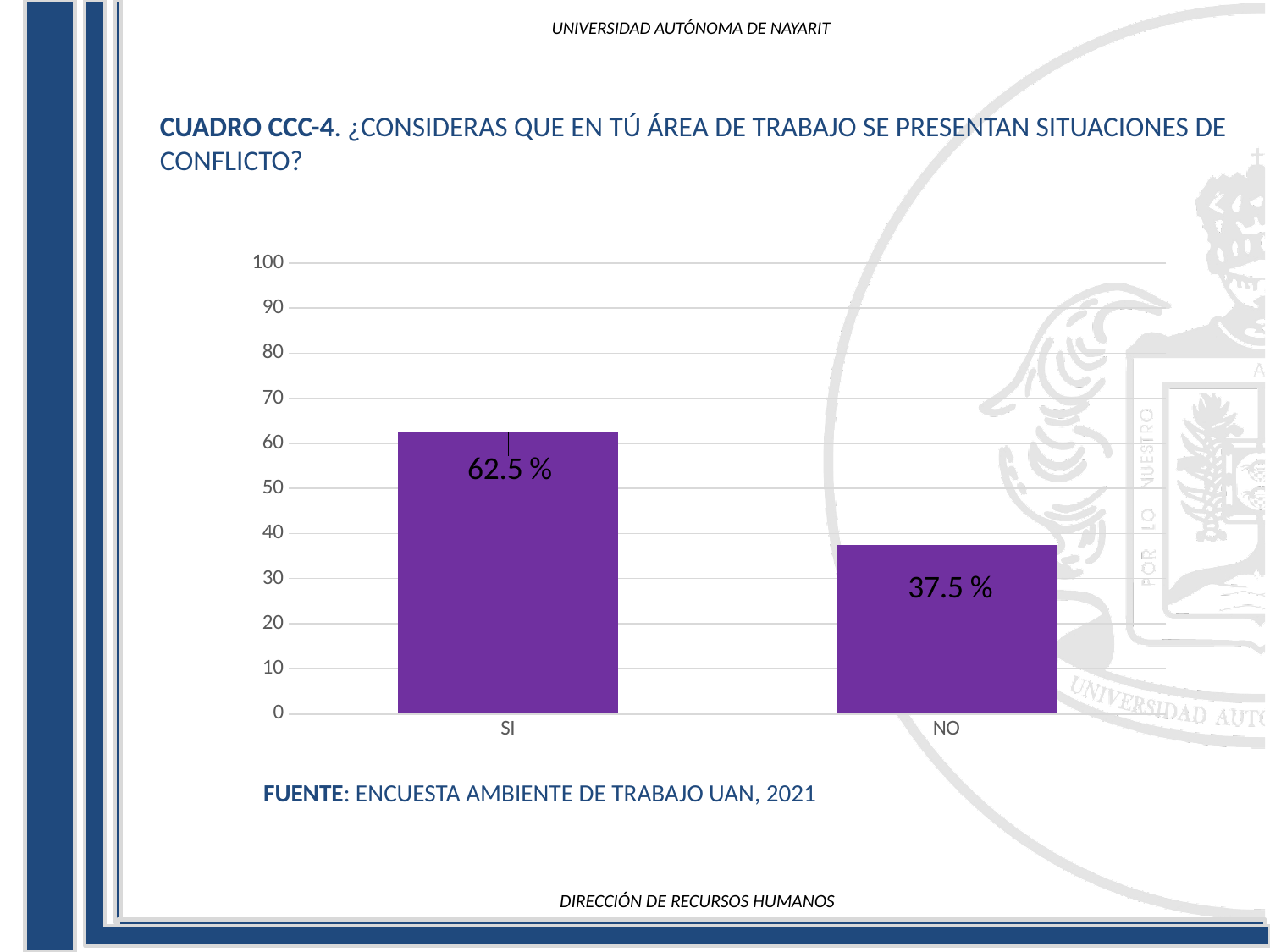
What is the highest value shown on the y axis? 100 Which is larger, the value for SI or the value for NO? SI What is the difference between the values for SI and NO? 25 % Is the value for NO greater or less than 40? less What is the value for NO? 37.5 % Which category has the highest value? SI Is the value for SI greater or less than 50? greater What kind of chart is shown on the slide? bar chart What colour are the bars in the chart? purple How many categories are shown on the x axis? 2 Which category has the lowest value? NO What is the value for SI? 62.5 %